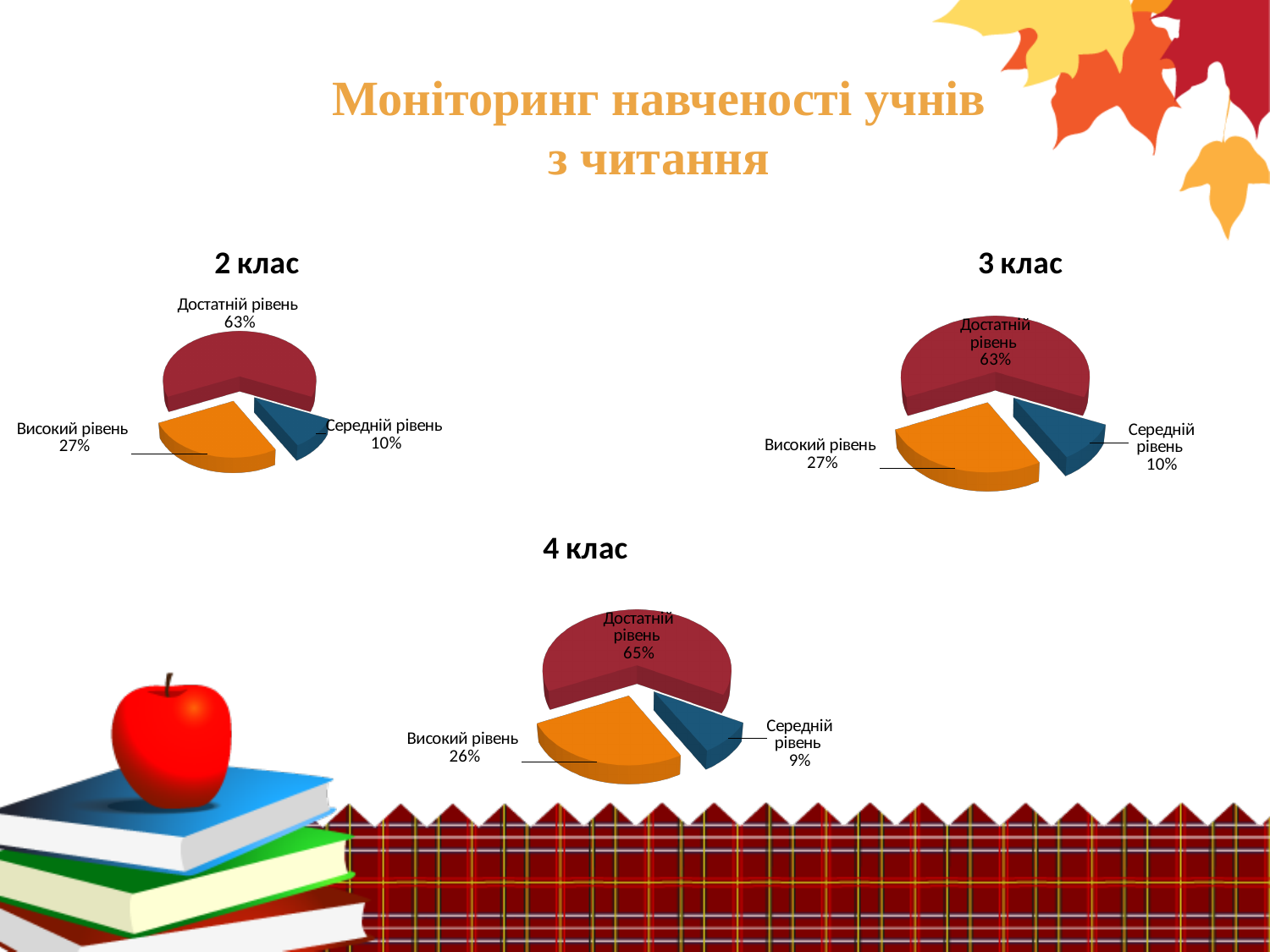
In the "2 клас" chart, what is the value for Достатній рівень? 63% In the "2 клас" chart, which is larger: Високий рівень or Середній рівень? Високий рівень In the "4 клас" chart, what is the value for Достатній рівень? 65% In the "4 клас" chart, what is the value for Середній рівень? 9% How many slices does the "3 клас" chart have? 3 In the "2 клас" chart, what is the value for Високий рівень? 27% How many charts are shown on the slide? 3 What type of chart is the "4 клас" chart? Pie chart In the "4 клас" chart, which category has the largest slice? Достатній рівень In the "3 клас" chart, what is the value for Середній рівень? 10% In the "3 клас" chart, which category has the smallest slice? Середній рівень In the "4 клас" chart, what is the difference between Високий рівень and Середній рівень? 17%